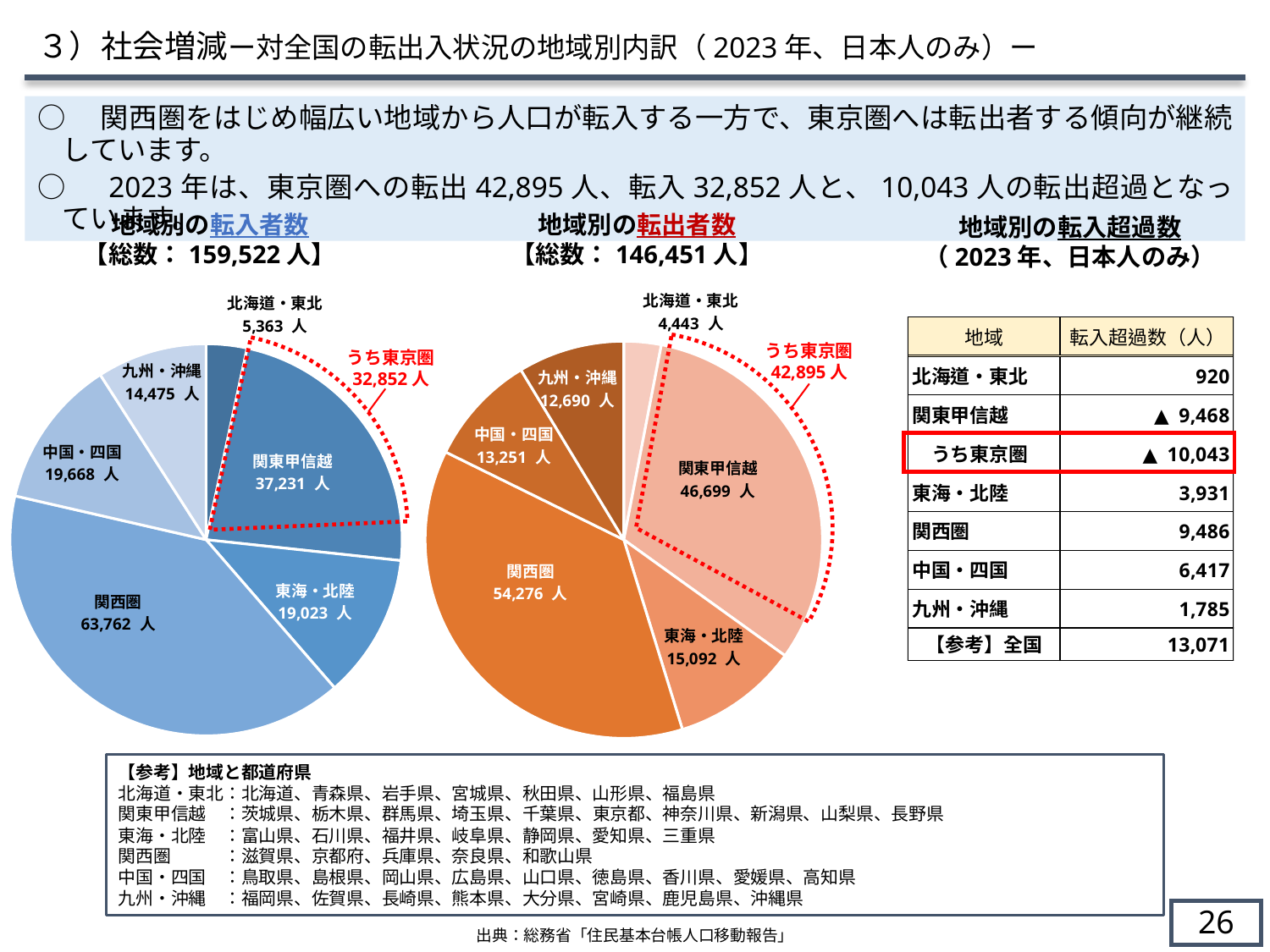
In the 地域別の転出者数 pie chart, which region has the smallest value? 北海道・東北 How many regions are shown as slices in the 地域別の転出者数 pie chart? 6 In the 地域別の転入者数 pie chart, what is the difference between 関西圏 and 関東甲信越? 26,531 人 In the 地域別の転入者数 pie chart, what is the value for うち東京圏? 32,852 人 What is the difference between the 関西圏 value in the 地域別の転入者数 pie chart and the 関西圏 value in the 地域別の転出者数 pie chart? 9,486 人 What kind of chart is used for 地域別の転入者数? pie chart In the 地域別の転出者数 pie chart, what is the value for 九州・沖縄? 12,690 人 In the 地域別の転出者数 pie chart, what is the value for 関東甲信越? 46,699 人 In the 地域別の転入者数 pie chart, what is the value for 関西圏? 63,762 人 In the 地域別の転入者数 pie chart, which region has the largest value? 関西圏 What total number of people is stated in the title of the 地域別の転出者数 pie chart? 146,451 人 In the 地域別の転出者数 pie chart, which is larger, 中国・四国 or 東海・北陸? 東海・北陸